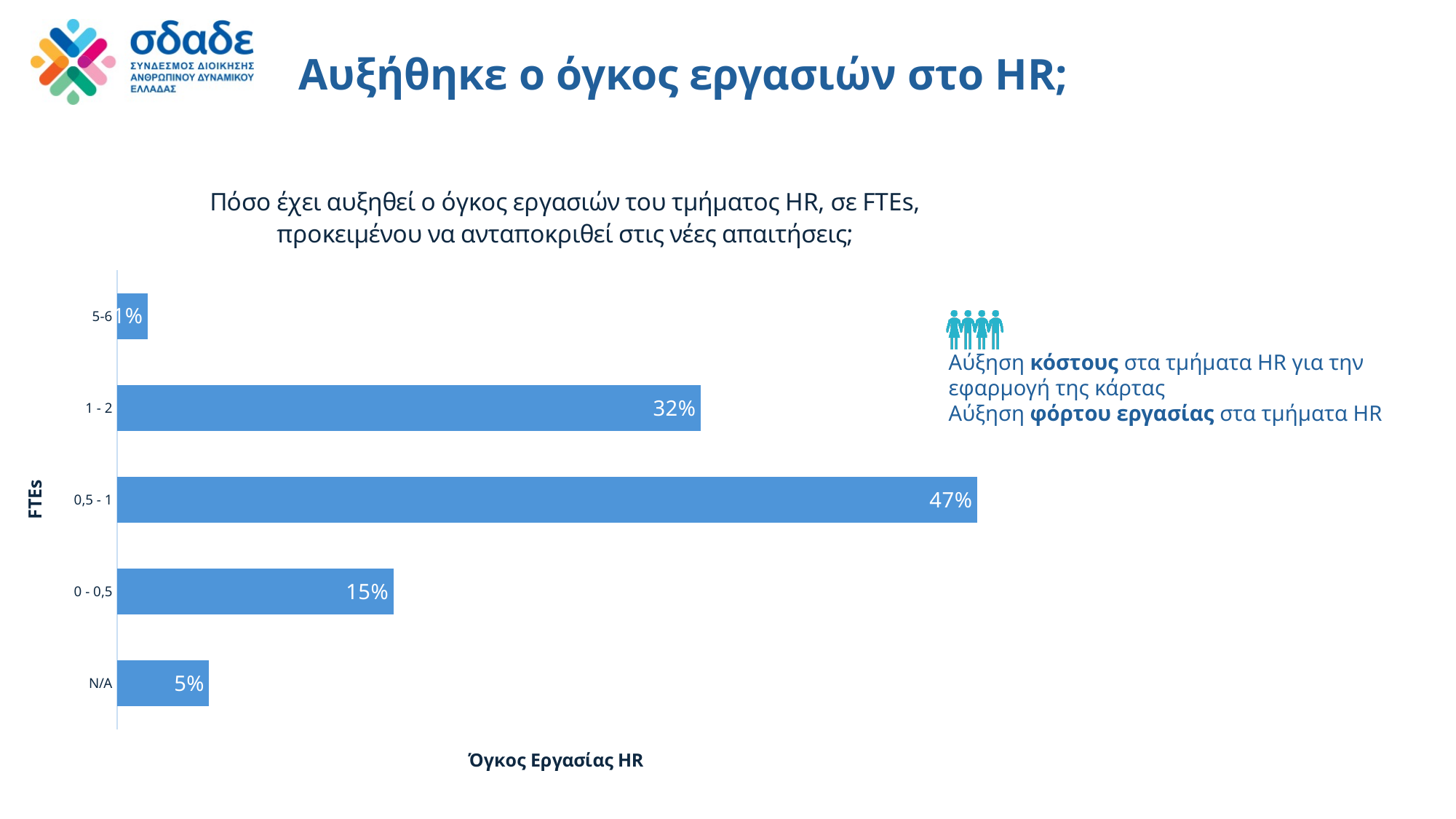
Which is larger, the value for 1 - 2 or the value for 0 - 0,5? 1 - 2 How many categories are shown on the chart? 5 What is the difference between the 0 - 0,5 and N/A categories? 10% Which FTE category has the highest percentage? 0,5 - 1 What percentage of respondents reported an increase of 0,5 - 1 FTEs? 47% What is the value for the N/A category? 5% What is the value shown for the 1 - 2 FTEs category? 32% What is the difference between the 0,5 - 1 and 1 - 2 categories? 15% What percentage is shown for the 0 - 0,5 FTEs category? 15% What is the label of the vertical axis of the chart? FTEs Which FTE category has the lowest percentage? 5-6 What type of chart is shown on the slide? Bar chart